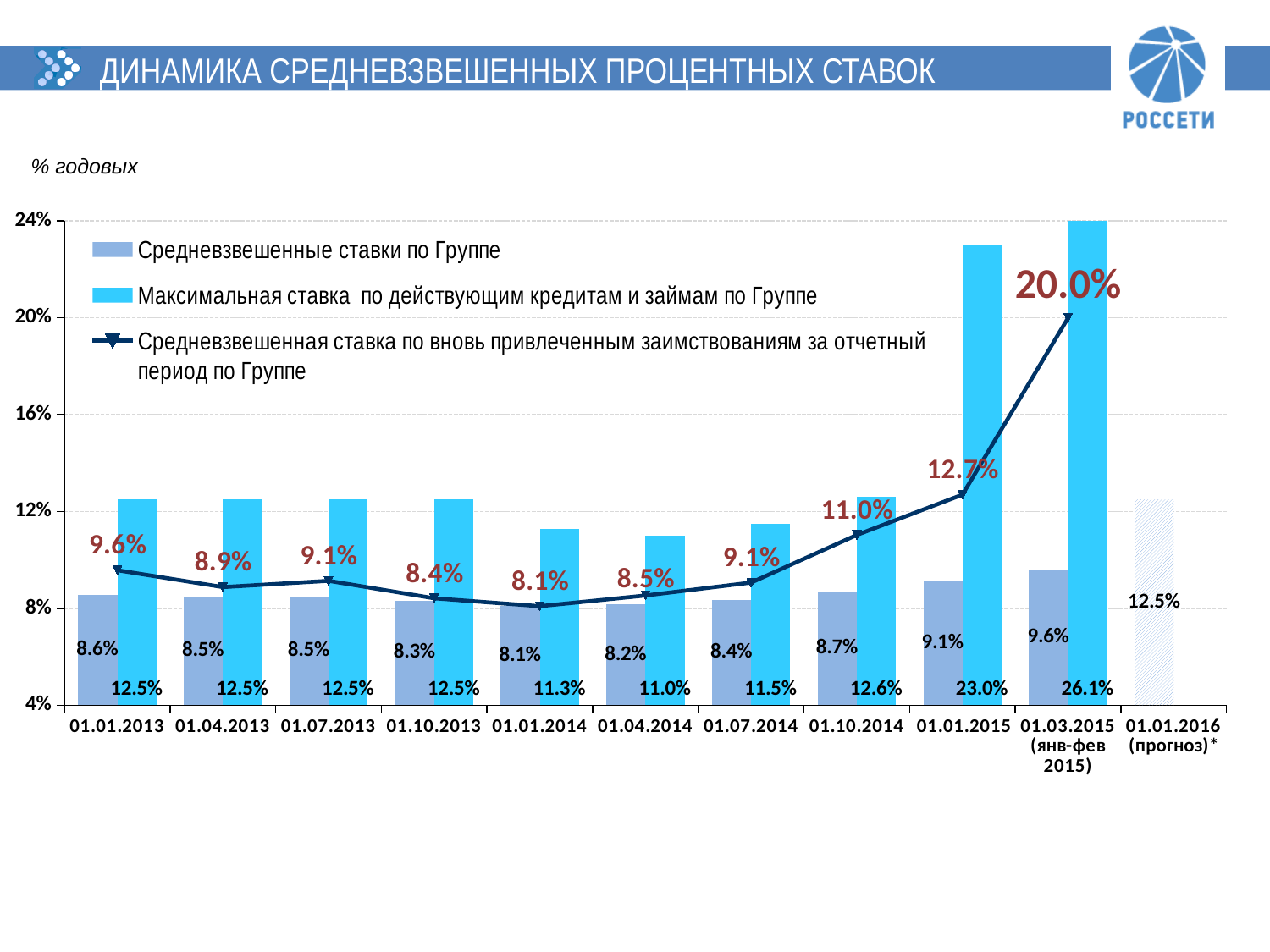
At which date is 'Средневзвешенные ставки по Группе' the lowest? 01.01.2014 What is the value of 'Средневзвешенные ставки по Группе' at 01.03.2015 (янв-фев 2015)? 9.6% What is the value of 'Средневзвешенная ставка по вновь привлеченным заимствованиям за отчетный период по Группе' at 01.10.2014? 11.0% How many series does the legend list? 3 What kind of chart is this? Combination of a bar chart and a line chart At which date is 'Максимальная ставка по действующим кредитам и займам по Группе' the highest? 01.03.2015 (янв-фев 2015) What value is shown for the forecast at 01.01.2016 (прогноз)*? 12.5% Does 'Средневзвешенная ставка по вновь привлеченным заимствованиям за отчетный период по Группе' rise or fall from 01.10.2014 to 01.03.2015? Rises Which is larger for 'Средневзвешенная ставка по вновь привлеченным заимствованиям за отчетный период по Группе': the value at 01.01.2013 or at 01.04.2013? 01.01.2013 How many dates are shown on the x axis? 11 What is the difference between 'Максимальная ставка по действующим кредитам и займам по Группе' at 01.03.2015 and at 01.01.2015? 3.1 percentage points What is the value of 'Максимальная ставка по действующим кредитам и займам по Группе' at 01.01.2015? 23.0%